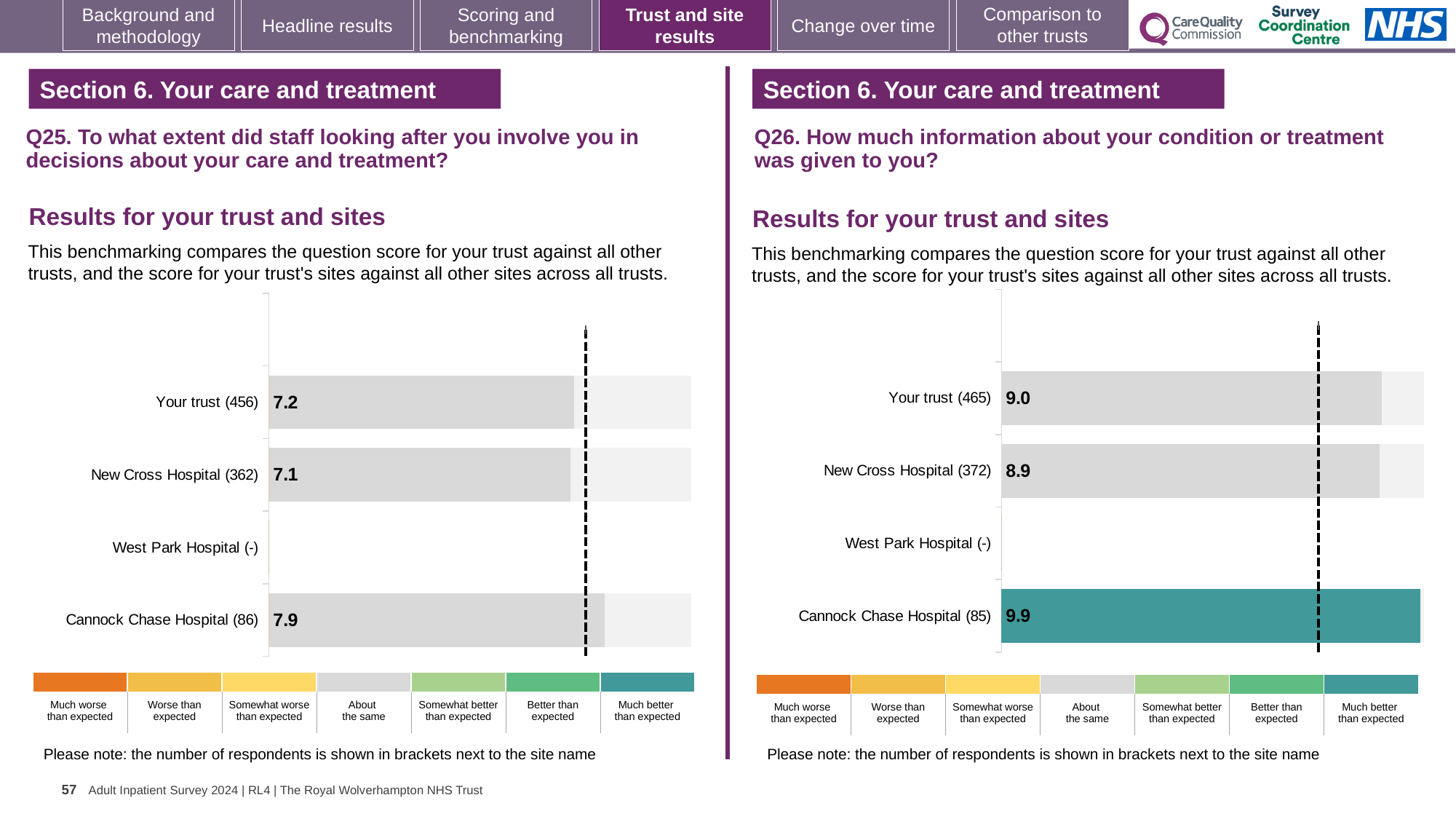
In the Q26 chart on the right, which has the larger score, Your trust or New Cross Hospital? Your trust In the Q25 chart on the left, how many respondents are shown for New Cross Hospital? 362 In the Q25 chart on the left, what is the score for Your trust? 7.2 In the Q26 chart on the right, which site has the highest score? Cannock Chase Hospital In the Q25 chart on the left, what is the difference between the scores for Cannock Chase Hospital and New Cross Hospital? 0.8 In the Q26 chart on the right, what is the score for Cannock Chase Hospital? 9.9 In the Q26 chart on the right, what is the score for New Cross Hospital? 8.9 In the Q25 chart on the left, what is the score for Cannock Chase Hospital? 7.9 In the Q26 chart on the right, what is the difference between the scores for Cannock Chase Hospital and Your trust? 0.9 What type of chart is used on the left for Q25? Bar chart In the Q26 chart on the right, which benchmark category does the colour of the Cannock Chase Hospital bar correspond to? Much better than expected In the Q25 chart on the left, which site has the highest score? Cannock Chase Hospital